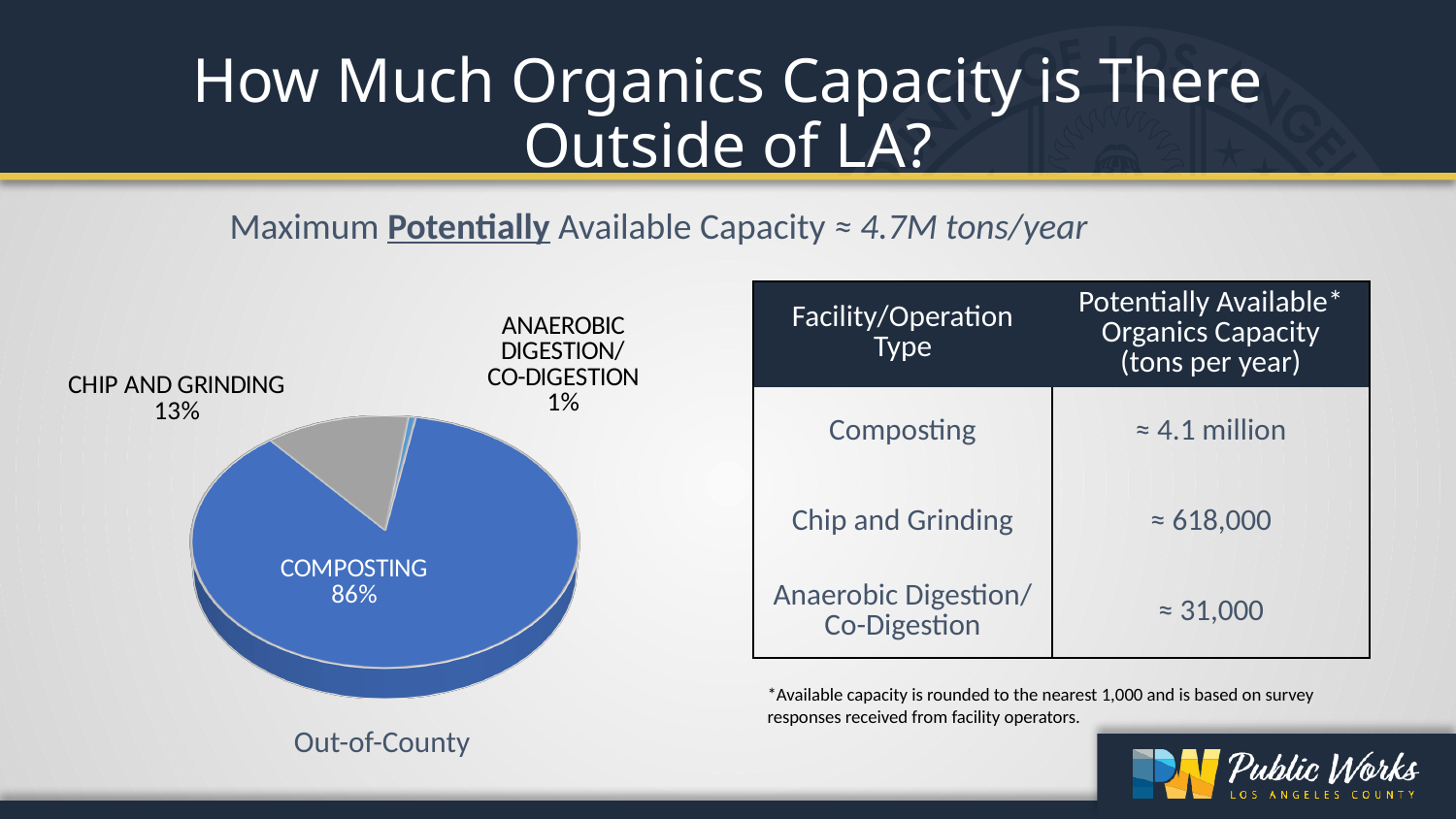
Which slice is larger, Chip and Grinding or Anaerobic Digestion/Co-Digestion? Chip and Grinding Which category has the smallest slice of the pie? Anaerobic Digestion/Co-Digestion What share of the pie does Anaerobic Digestion/Co-Digestion have? 1% How many slices does the pie chart have? 3 Which category has the largest slice of the pie? Composting What share of the pie does Composting have? 86% What is the difference in percentage points between the Composting slice and the Chip and Grinding slice? 73 What kind of chart is shown on the slide? pie chart What label appears below the pie chart? Out-of-County What colour is the Composting slice of the pie? blue What share of the pie does Chip and Grinding have? 13%